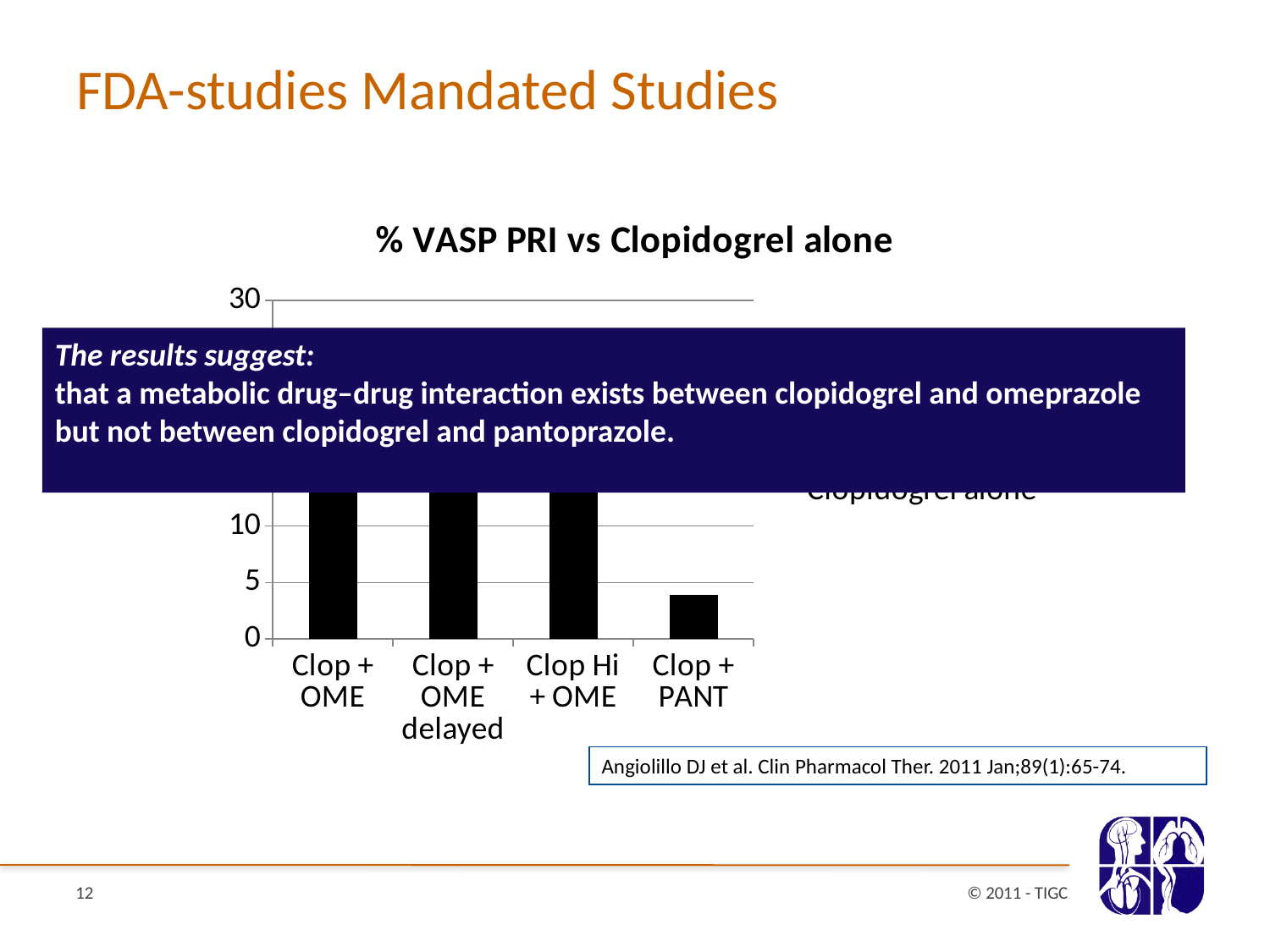
Which is larger, the value for Clop Hi + OME or the value for Clop + PANT? Clop Hi + OME Is the value for Clop Hi + OME greater or less than 10? greater What is the highest value shown on the y axis of the chart? 30 Is the value for Clop + OME delayed greater or less than 5? greater Is the value for Clop + PANT greater or less than 5? less How many categories are shown on the x axis of the chart? 4 Which category has the lowest value in the chart? Clop + PANT What kind of chart is shown on the slide? bar chart What is the title of the chart? % VASP PRI vs Clopidogrel alone Which is larger, the value for Clop + OME or the value for Clop + PANT? Clop + OME